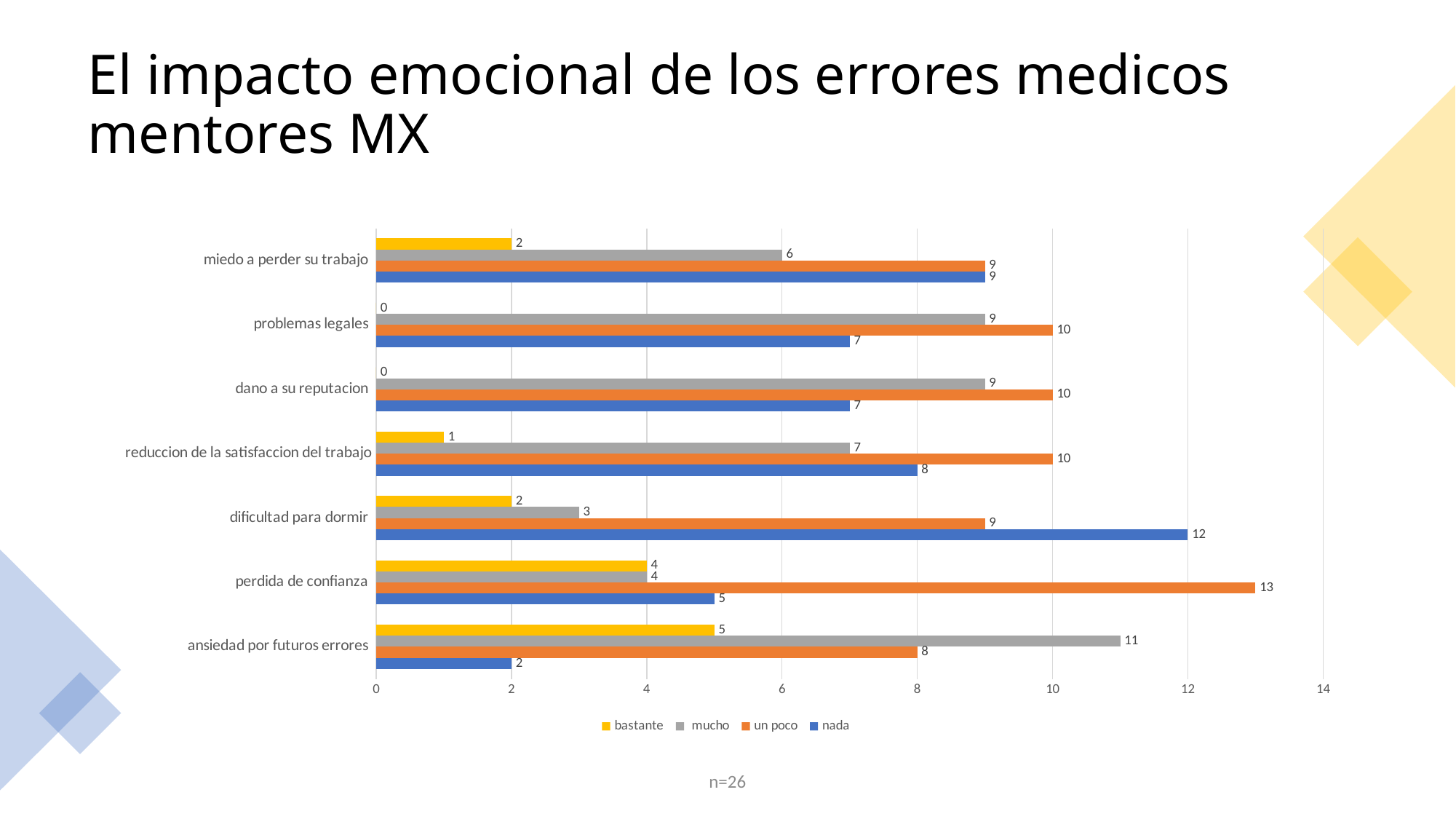
Which is larger for "miedo a perder su trabajo": the "mucho" value or the "bastante" value? mucho How many categories are shown on the chart? 7 What kind of chart is shown on the slide? bar chart Which category has the lowest value for the "nada" series? ansiedad por futuros errores What is the value for "mucho" in the "ansiedad por futuros errores" category? 11 What colour represents the "un poco" series? orange What is the value for "un poco" in the "perdida de confianza" category? 13 What is the difference between the "un poco" and "nada" values for "perdida de confianza"? 8 How many series does the legend list? 4 Which category has the highest value for the "bastante" series? ansiedad por futuros errores What is the value for "nada" in the "dificultad para dormir" category? 12 What is the value for "bastante" in the "problemas legales" category? 0